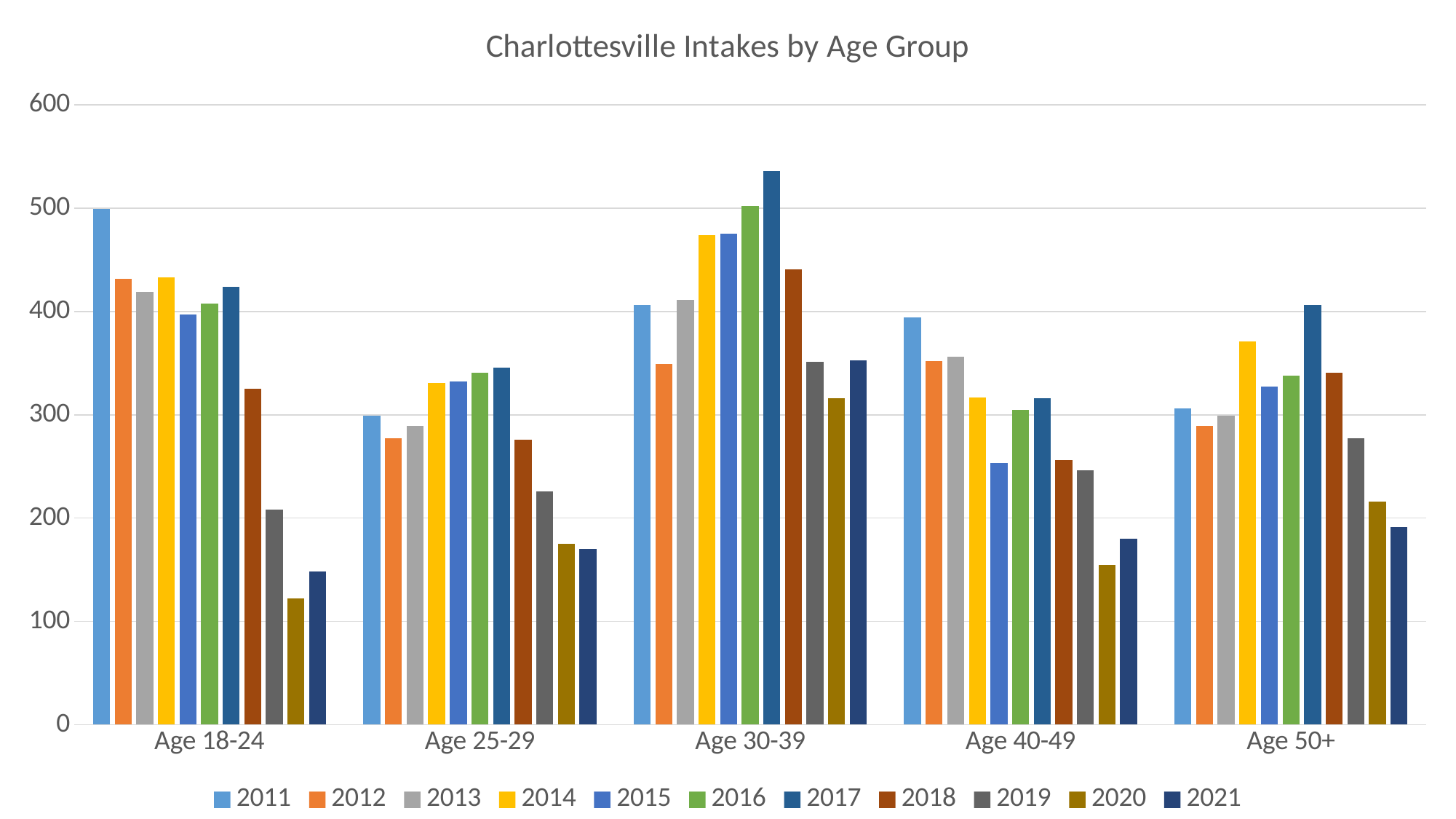
Which year has the tallest bar in the Age 50+ group? 2017 In the Age 30-39 group, which is larger: the value for 2017 or the value for 2018? 2017 What is the title of the chart? Charlottesville Intakes by Age Group What kind of chart is shown on the slide? Bar chart How many series (years) does the legend list? 11 Is the value for 2011 in the Age 18-24 group greater or less than 400? greater How many age groups are shown on the x axis? 5 Which age group has the lowest value for 2020? Age 18-24 Is the value for 2020 in the Age 25-29 group greater or less than 200? less Which age group has the highest value for 2017? Age 30-39 In the Age 40-49 group, do the values rise or fall from 2017 to 2020? fall Is the value for 2017 in the Age 30-39 group greater or less than 500? greater